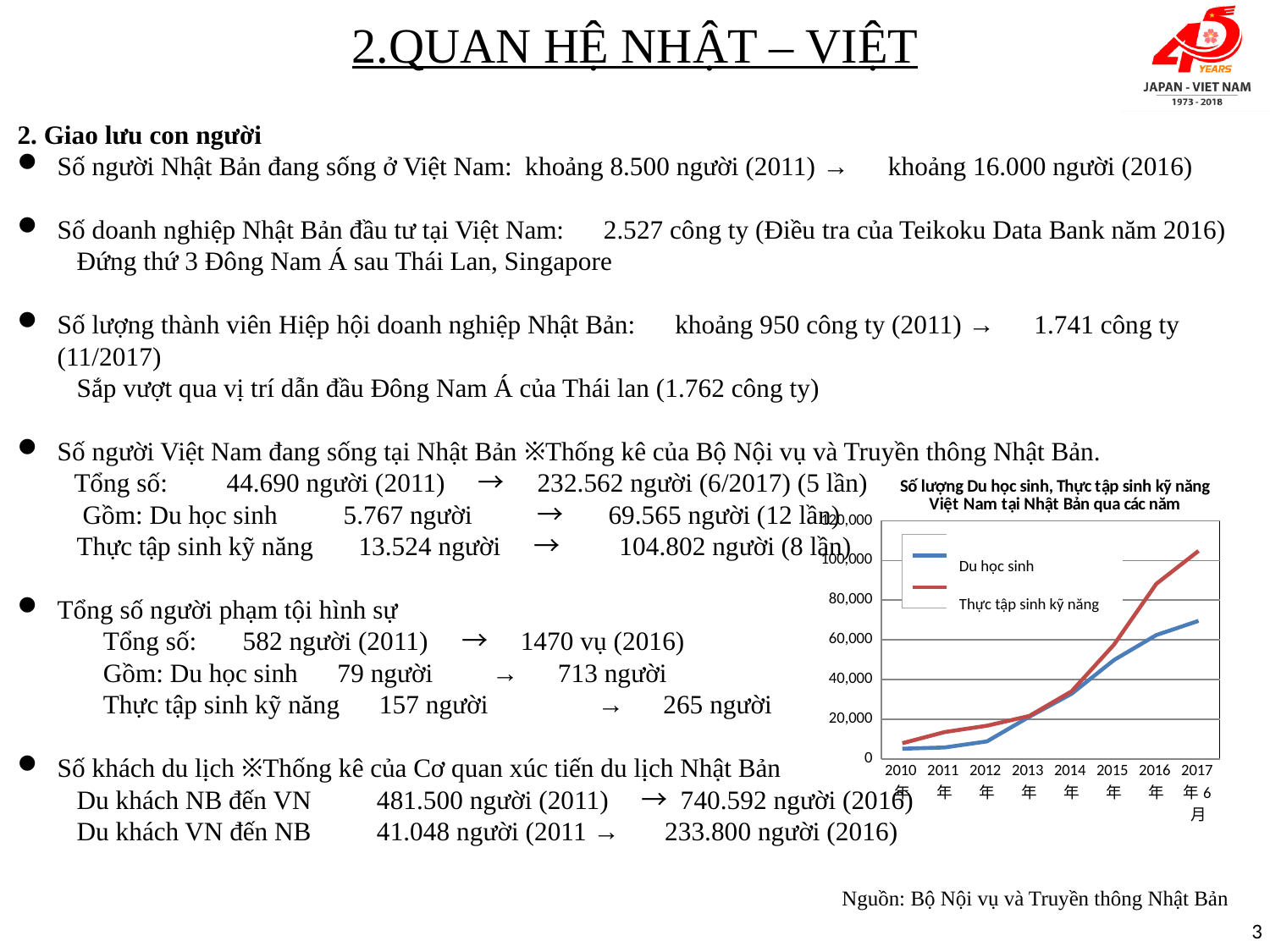
What kind of chart is shown on the slide? line chart Is the value for Du học sinh in 2017 greater or less than 80,000? less How many series does the chart's legend list? 2 Do the values for Thực tập sinh kỹ năng rise or fall from 2010 to 2017? rise Do the values for Du học sinh rise or fall from 2010 to 2017? rise Is the value for Thực tập sinh kỹ năng in 2017 greater or less than 100,000? greater Which series has the larger value in 2017, Du học sinh or Thực tập sinh kỹ năng? Thực tập sinh kỹ năng Is the value for Thực tập sinh kỹ năng in 2014 greater or less than 40,000? less How many time points are shown along the x axis of the chart? 8 What colour is the line for Du học sinh in the chart? blue Which series has the larger value in 2010, Du học sinh or Thực tập sinh kỹ năng? Thực tập sinh kỹ năng